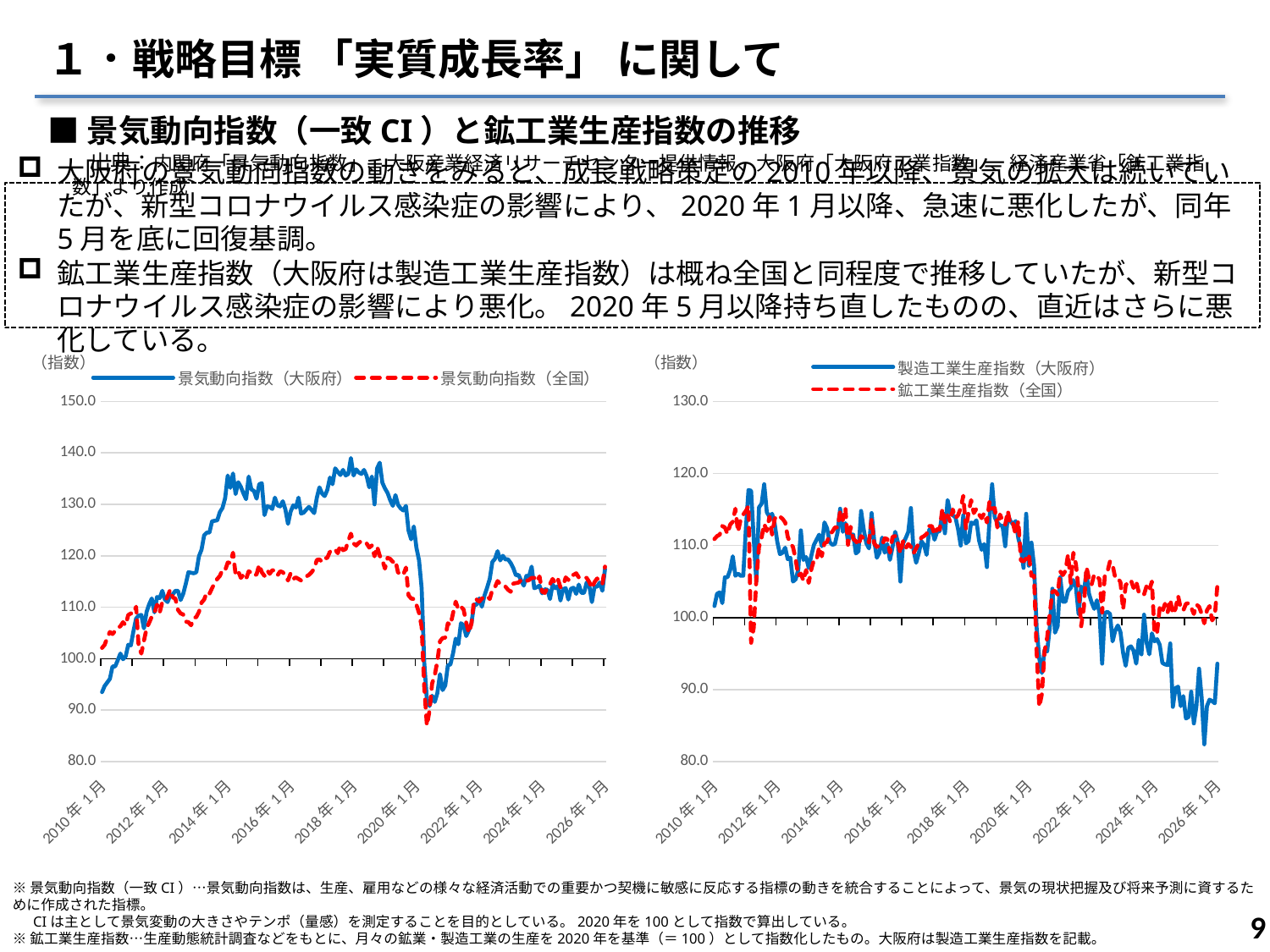
In the right chart, around 2025, which series is higher: 製造工業生産指数（大阪府） or 鉱工業生産指数（全国）? 鉱工業生産指数（全国） In the left chart, is the peak value of 景気動向指数（大阪府） around 2018 greater or less than 130? greater In the left chart, does 景気動向指数（大阪府） generally rise or fall from 2010年1月 to 2018年1月? rise In the right chart, is the most recent value of 製造工業生産指数（大阪府） greater or less than 100? less In the left chart, is the value of 景気動向指数（全国） around 2018 greater or less than 130? less How many series does the legend of the right chart (製造工業生産指数・鉱工業生産指数) list? 2 How many series does the legend of the left chart (景気動向指数) list? 2 What kind of chart is the left chart (景気動向指数)? line chart In the left chart, which series is drawn as a red dashed line? 景気動向指数（全国） In the left chart, around 2018, which series is higher: 景気動向指数（大阪府） or 景気動向指数（全国）? 景気動向指数（大阪府）